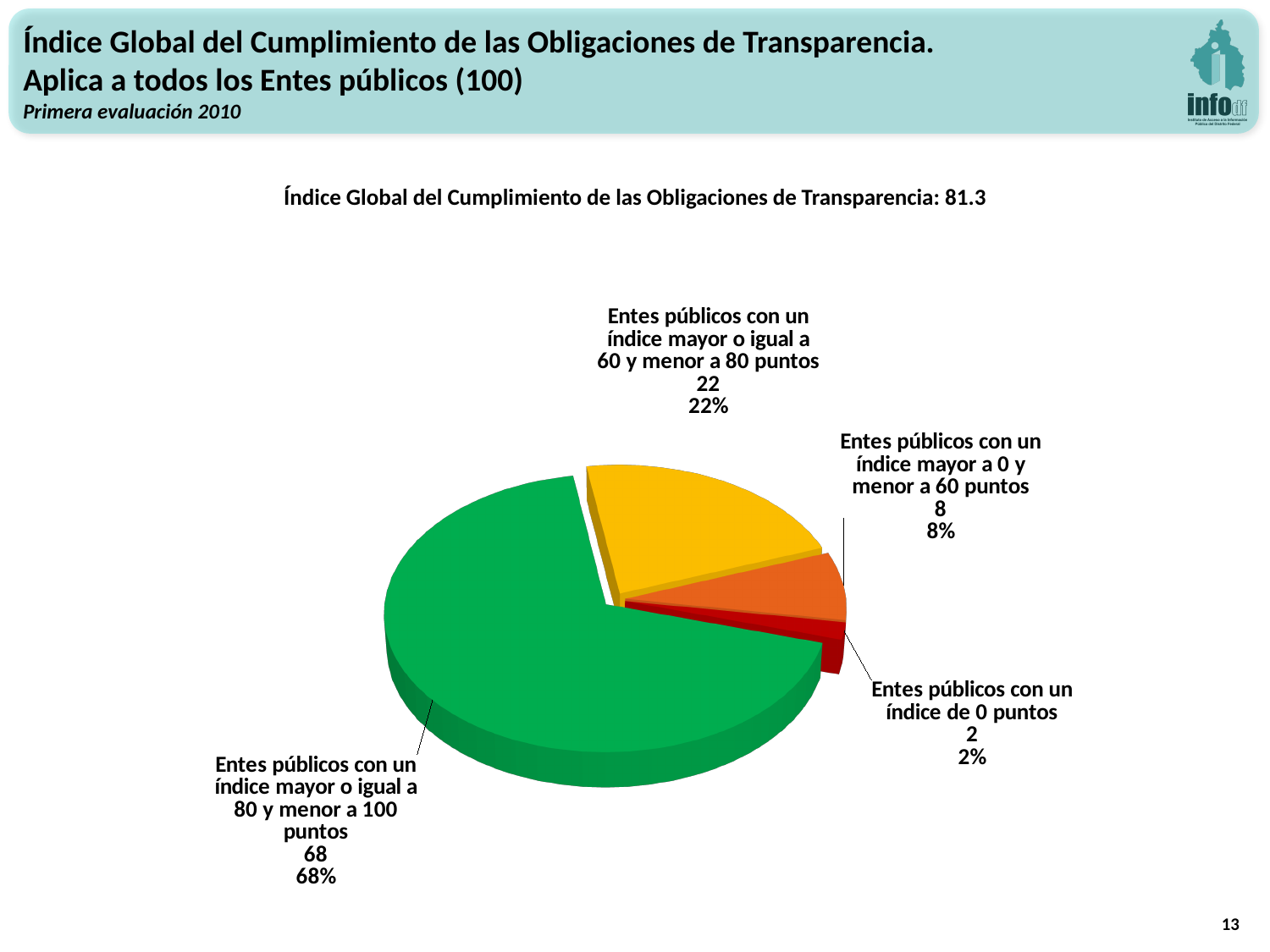
How many entes públicos have an índice de 0 puntos? 2 Which category has the smallest slice of the pie? Entes públicos con un índice de 0 puntos What share of the pie is the slice for entes públicos con un índice mayor o igual a 60 y menor a 80 puntos? 22% How many entes públicos have an índice mayor a 0 y menor a 60 puntos? 8 How many slices does the pie chart have? 4 What is the difference between the number of entes públicos with an índice mayor o igual a 80 y menor a 100 puntos and those with an índice mayor o igual a 60 y menor a 80 puntos? 46 What value of the Índice Global del Cumplimiento de las Obligaciones de Transparencia is stated above the chart? 81.3 Which category has the largest slice of the pie? Entes públicos con un índice mayor o igual a 80 y menor a 100 puntos How many entes públicos have an índice mayor o igual a 80 y menor a 100 puntos? 68 What kind of chart is shown on the slide? pie chart What share of the pie is the slice for entes públicos con un índice de 0 puntos? 2% How many entes públicos have an índice mayor o igual a 60 y menor a 80 puntos? 22